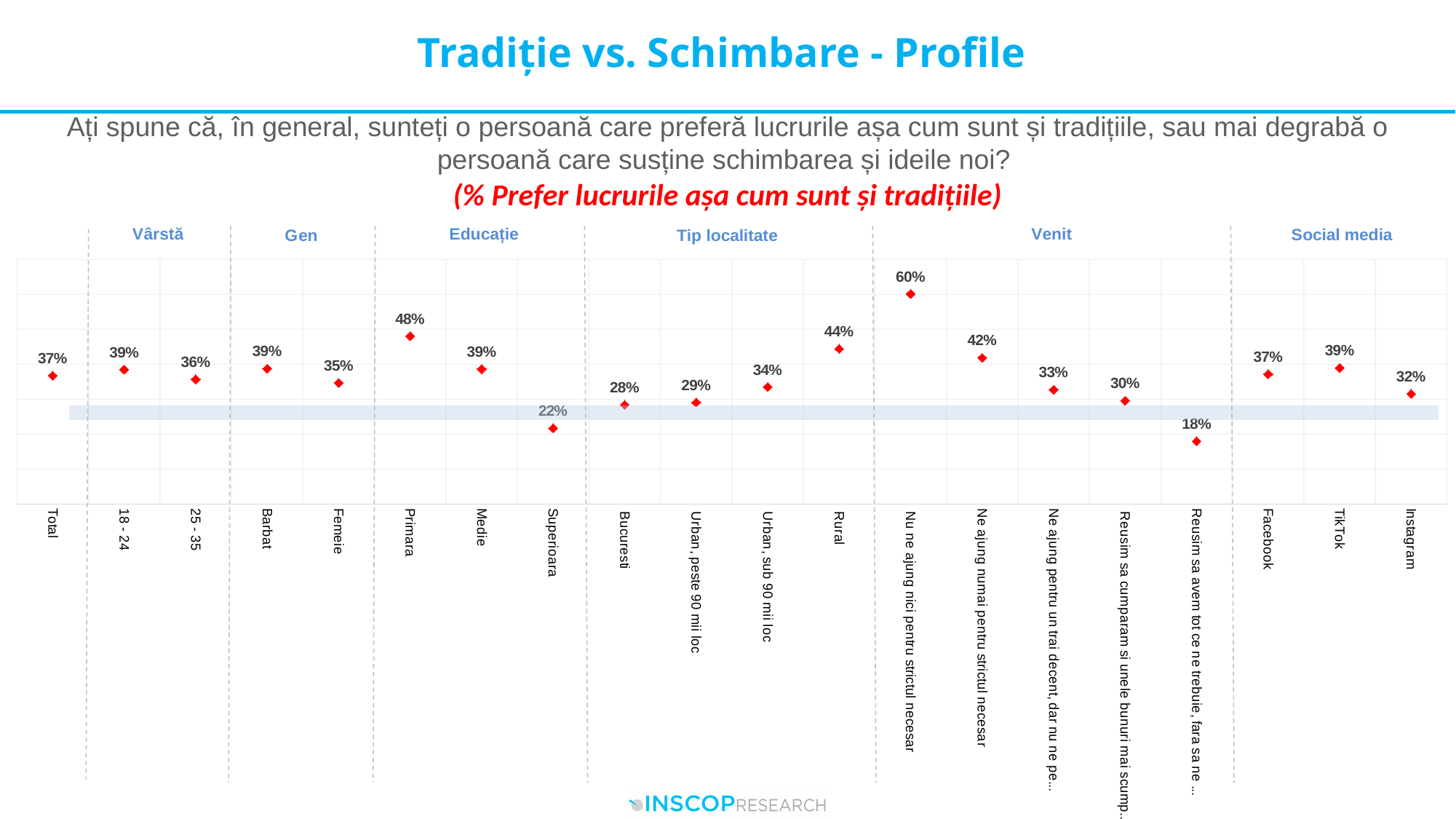
What kind of chart is shown on the slide? Dot (scatter) chart What is the value for Total? 37% What is the value for Instagram? 32% What is the value for Primara? 48% Which category has the highest value? Nu ne ajung nici pentru strictul necesar What is the value for Rural? 44% Which group heading covers the categories Facebook, TikTok and Instagram? Social media What is the difference between the values for Rural and Bucuresti? 16 percentage points What is the difference between the values for Primara and Superioara? 26 percentage points Which is larger, the value for Barbat or the value for Femeie? Barbat Which category has the lowest value? Reusim sa avem tot ce ne trebuie, fara sa ne ... How many data points are plotted on the chart? 20